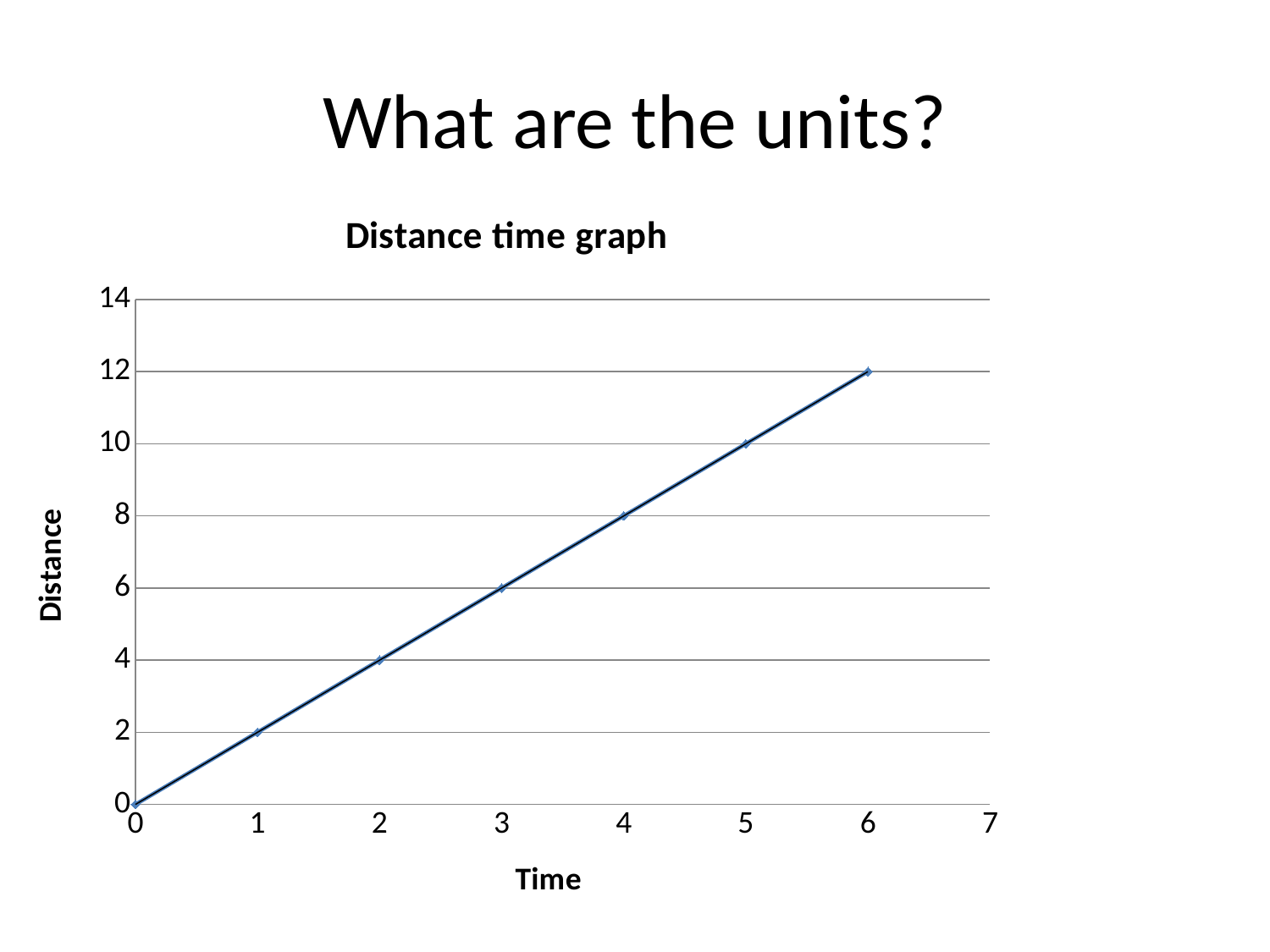
Does the distance rise or fall as time increases along the x axis? rise At which time value is the distance lowest? 0 What kind of chart is shown on the slide? line chart How many data points are plotted on the line? 7 What is the distance value at time 1? 2 Which is larger, the distance at time 4 or the distance at time 2? time 4 What is the distance value at time 6? 12 What is the title of the chart? Distance time graph At which time value is the distance highest? 6 What is the difference between the distance at time 5 and the distance at time 2? 6 What is the label of the vertical axis? Distance What is the distance value at time 3? 6